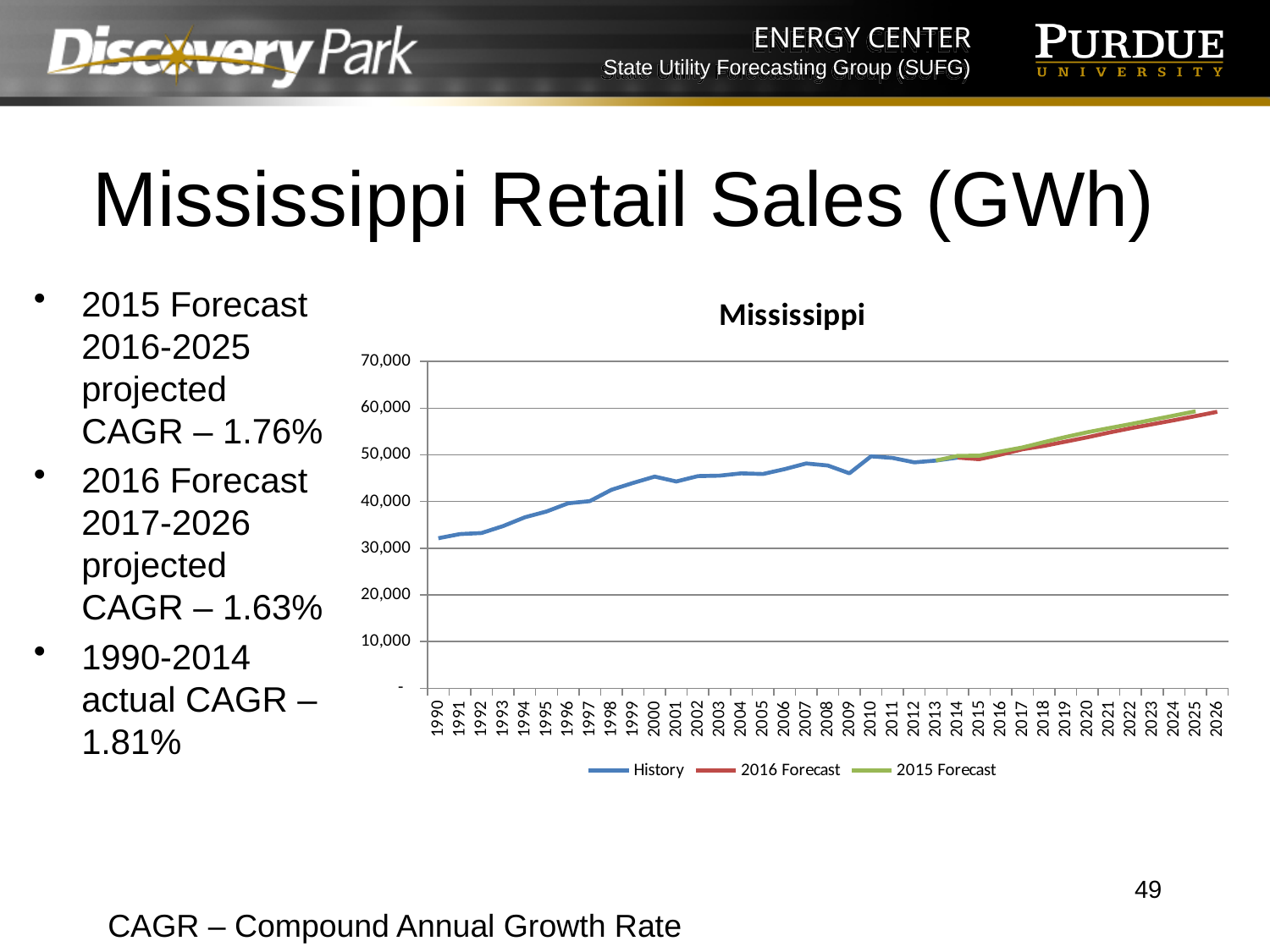
How many series does the chart legend list? 3 Which is larger: the value for 1990 or the value for 2026? 2026 Is the History value for 1990 greater or less than 30,000? greater Do the values generally rise or fall from 1990 to 2026? rise In which year is the History series at its lowest? 1990 What is the title of the chart? Mississippi What kind of chart is shown on the slide? line chart How many years are labelled on the x axis of the chart? 37 Is the History value for 1995 greater or less than 40,000? less Is the History value for 2000 greater or less than 40,000? greater Which series is drawn in blue in the chart? History